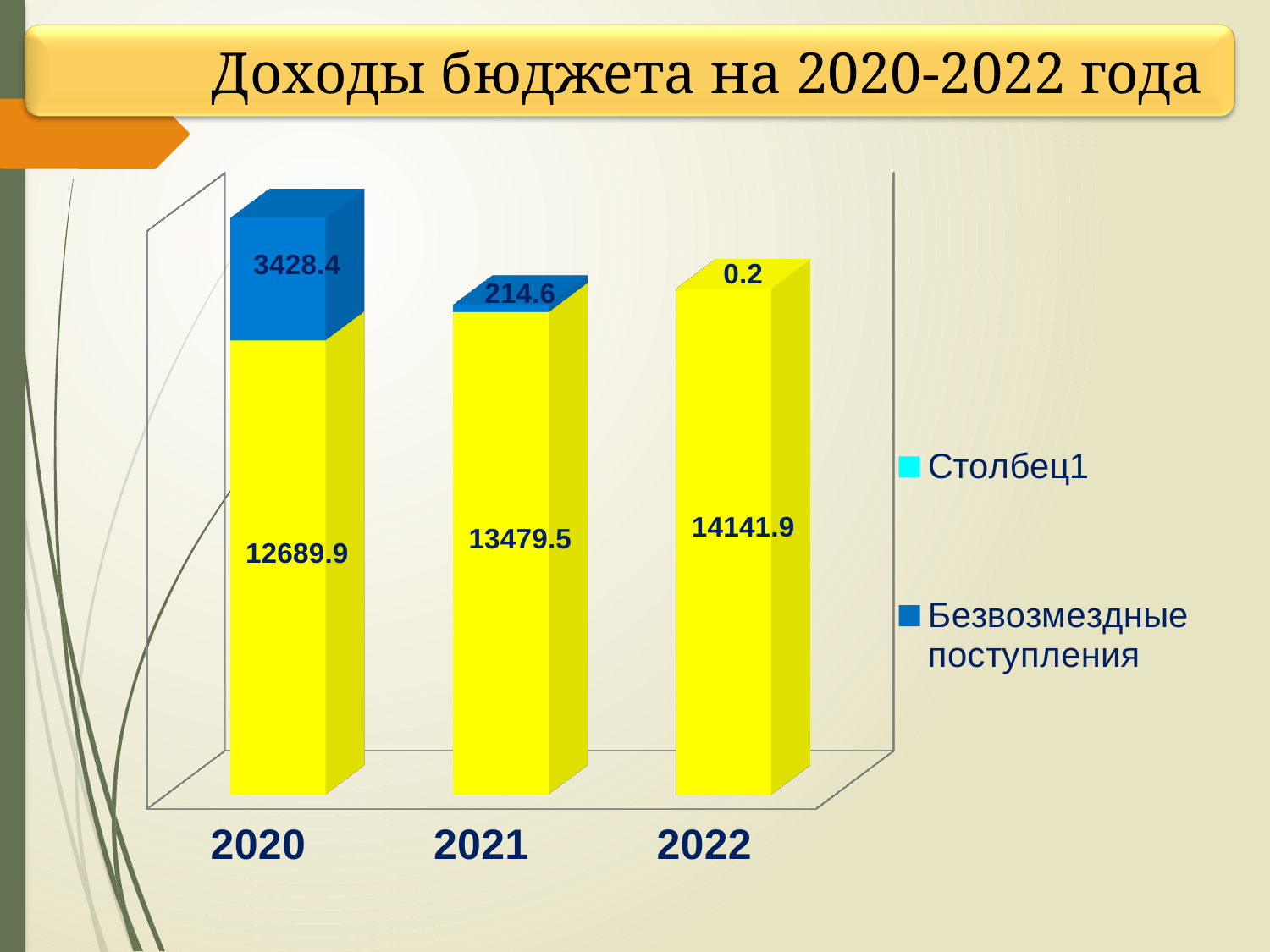
Which year has the lowest value for Безвозмездные поступления? 2022 What kind of chart is shown on the slide? Stacked bar chart How many series does the legend list? 2 Which is larger: Безвозмездные поступления in 2020 or in 2021? 2020 What is the value of Безвозмездные поступления for 2022? 0.2 How many years are shown on the x axis? 3 What is the difference between the Безвозмездные поступления values for 2020 and 2021? 3213.8 What is the total of the stacked bar for 2020? 16118.3 What is the value of Безвозмездные поступления for 2021? 214.6